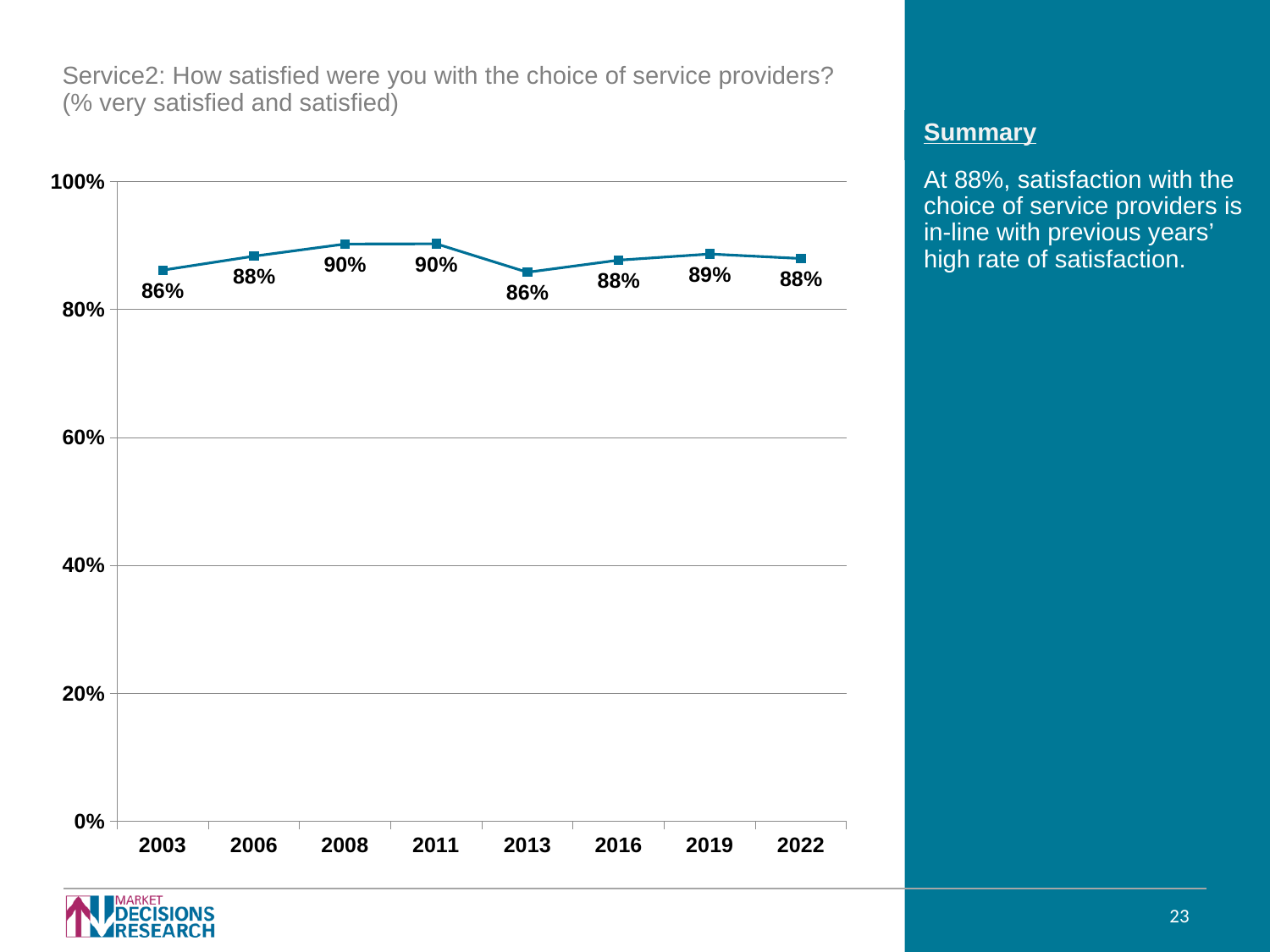
Did the value rise or fall from 2011 to 2013? fall Is the value for 2016 greater or less than 80%? greater What kind of chart is shown on the slide? line chart What is the value for 2013? 86% What is the highest value shown on the chart? 90% What is the lowest value shown on the chart? 86% What is the value for 2022? 88% What is the difference between the values for 2008 and 2013? 4% Which is larger, the value for 2019 or the value for 2022? 2019 How many years are plotted on the x axis? 8 What is the value for 2003? 86% What is the value for 2019? 89%